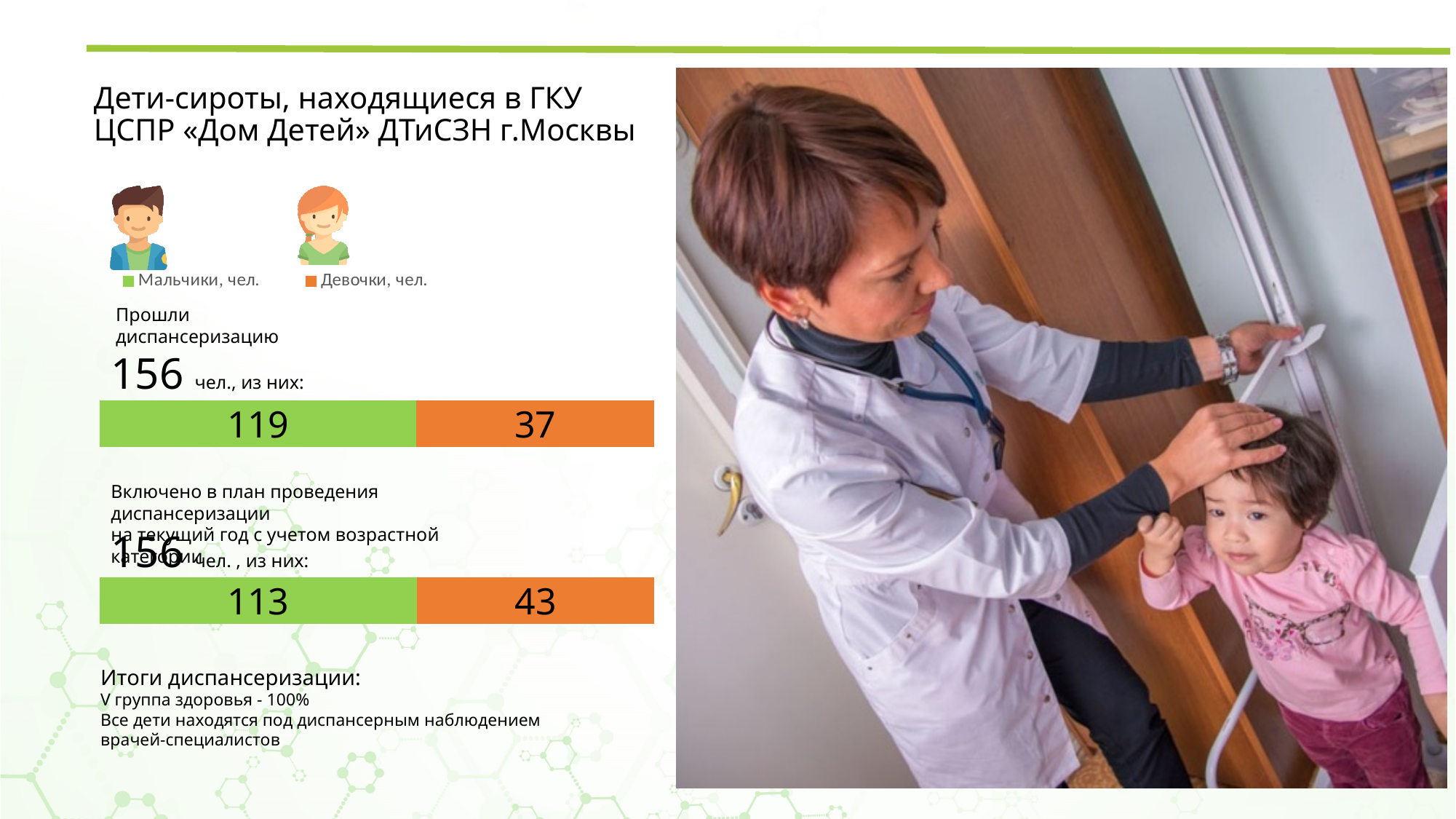
In the upper bar chart (Прошли диспансеризацию), what is the value for Девочки, чел.? 37 In the lower bar chart (Включено в план проведения диспансеризации), what is the value for Мальчики, чел.? 113 In the lower bar chart, what is the total of the stacked bar? 156 In the upper bar chart, what is the difference between the values for Мальчики and Девочки? 82 In the upper bar chart, which series has the larger value, Мальчики or Девочки? Мальчики In the upper bar chart (Прошли диспансеризацию), what is the value for Мальчики, чел.? 119 What kind of chart is used to show the Прошли диспансеризацию data? Stacked bar chart Which colour represents Девочки, чел. in the charts? Orange In the lower bar chart (Включено в план проведения диспансеризации), what is the value for Девочки, чел.? 43 How many series does the legend list? 2 In the lower bar chart, what is the difference between the values for Мальчики and Девочки? 70 In the upper bar chart, what is the total of the stacked bar? 156